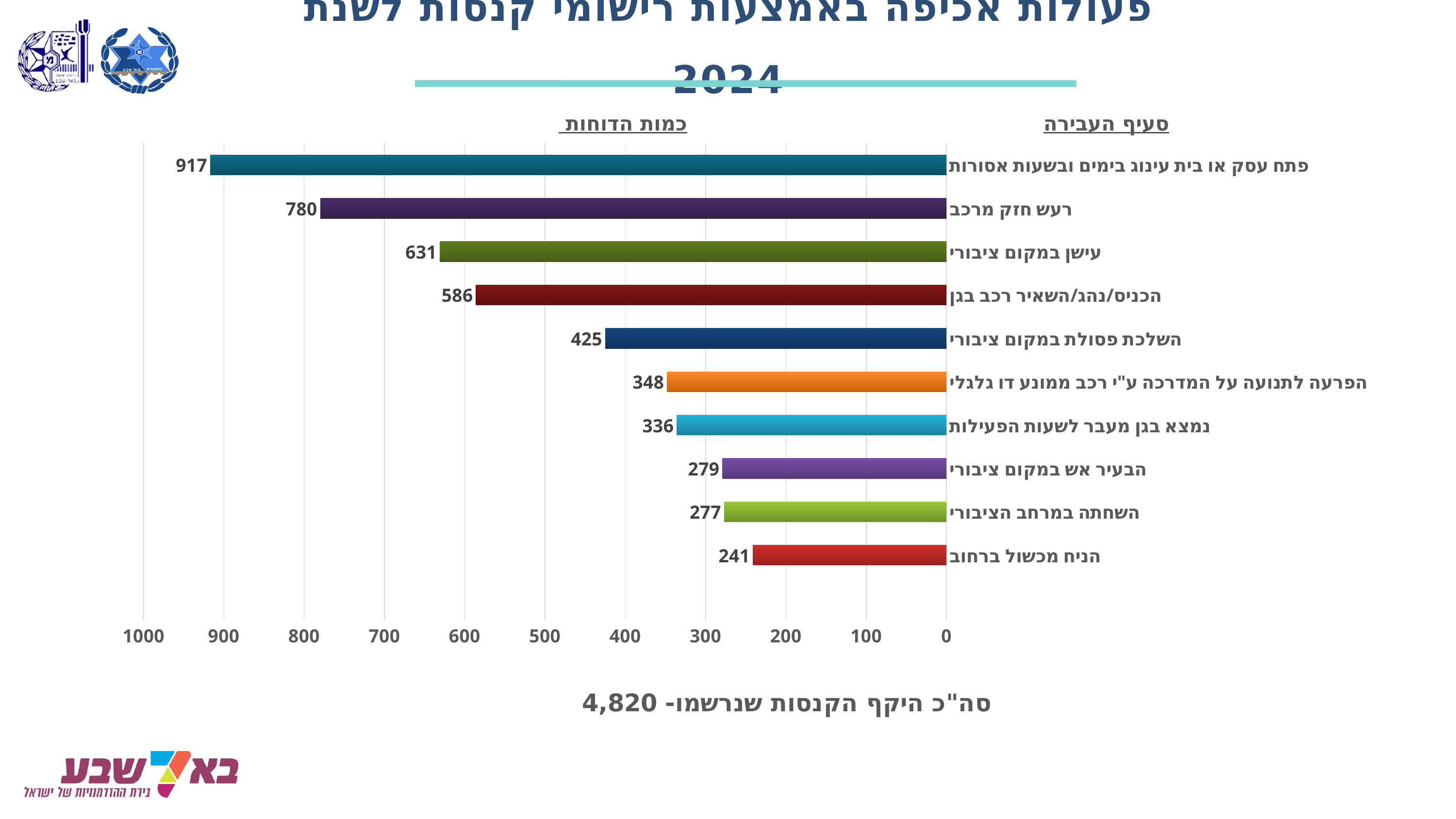
Which category has the lowest value? הניח מכשול ברחוב What is the total number of fines stated on the slide? 4,820 What is the value for the category "פתח עסק או בית עינוג בימים ובשעות אסורות"? 917 What is the value for the category "הניח מכשול ברחוב"? 241 What kind of chart is shown on the slide? bar chart What is the heading above the category labels on the right side of the chart? סעיף העבירה Which category has the highest value? פתח עסק או בית עינוג בימים ובשעות אסורות Which is larger, the value for "השלכת פסולת במקום ציבורי" or the value for "נמצא בגן מעבר לשעות הפעילות"? השלכת פסולת במקום ציבורי Is the value for "הפרעה לתנועה על המדרכה ע"י רכב ממונע דו גלגלי" greater or less than 400? less What is the difference between the values for "רעש חזק מרכב" and "הכניס/נהג/השאיר רכב בגן"? 194 How many categories are shown in the chart? 10 What is the value for the category "עישן במקום ציבורי"? 631